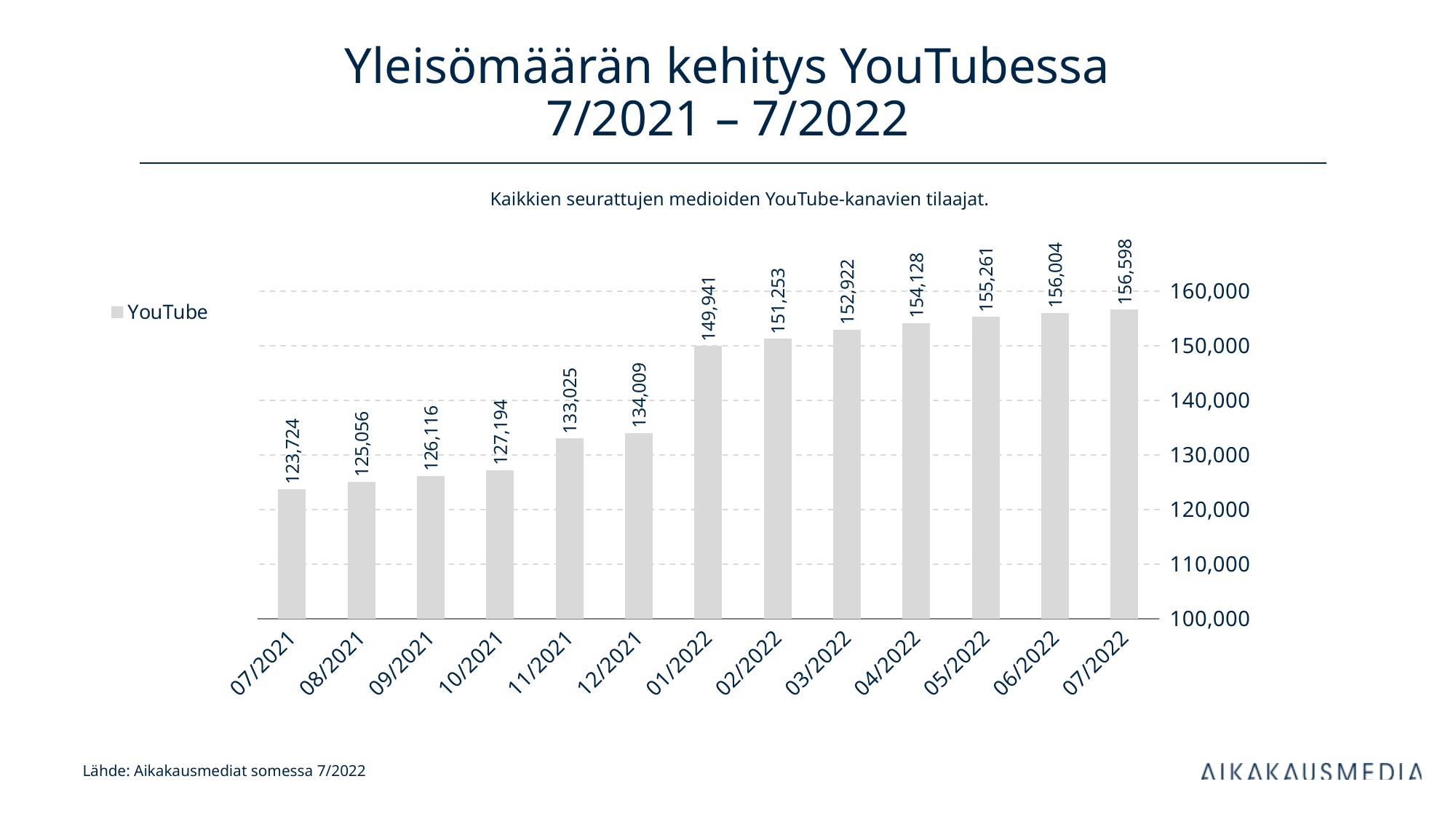
Do the values rise or fall from 07/2021 to 07/2022? rise What kind of chart is shown on the slide? bar chart How many months are shown on the x axis? 13 What is the value for 07/2021? 123,724 Is the value for 03/2022 greater or less than 150,000? greater Which is larger, the value for 11/2021 or the value for 12/2021? 12/2021 What is the difference between the values for 01/2022 and 12/2021? 15,932 What is the value for 01/2022? 149,941 What is the difference between the values for 07/2022 and 07/2021? 32,874 Which month has the lowest value? 07/2021 What is the value for 07/2022? 156,598 Which month has the highest value? 07/2022